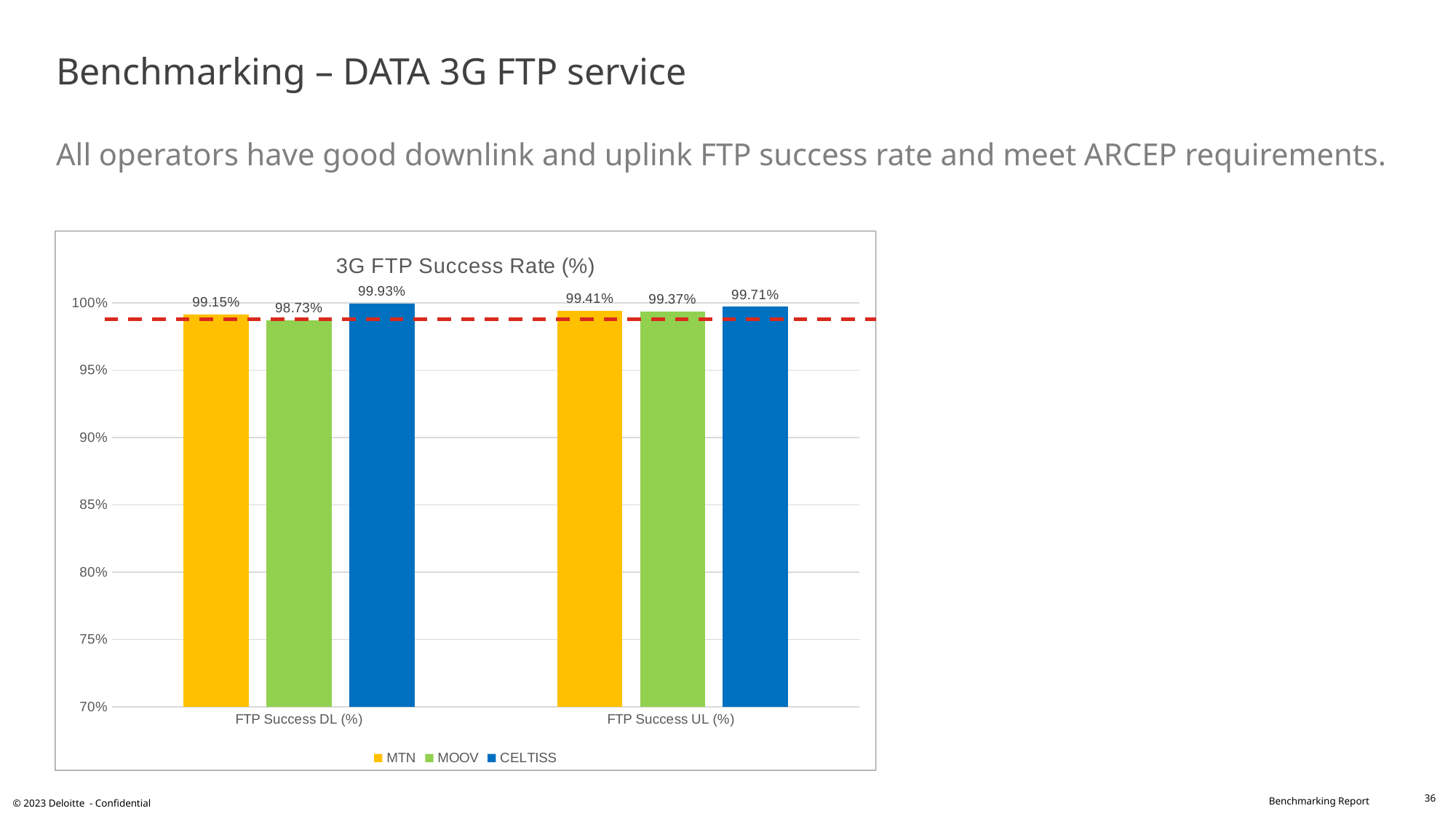
For FTP Success DL (%), which is larger: the MTN value or the CELTISS value? CELTISS What kind of chart is shown on the slide? Bar chart How many series does the legend list? 3 Which operator has the highest FTP Success UL (%)? CELTISS What is the FTP Success DL (%) value for MTN? 99.15% What is the title of the chart? 3G FTP Success Rate (%) Which operator has the lowest FTP Success DL (%)? MOOV What is the FTP Success UL (%) value for MOOV? 99.37% What is the FTP Success DL (%) value for CELTISS? 99.93% What is the difference between the CELTISS and MOOV values for FTP Success DL (%)? 1.20% How many categories are shown on the x axis? 2 Is the FTP Success UL (%) value for MTN greater or less than 95%? greater